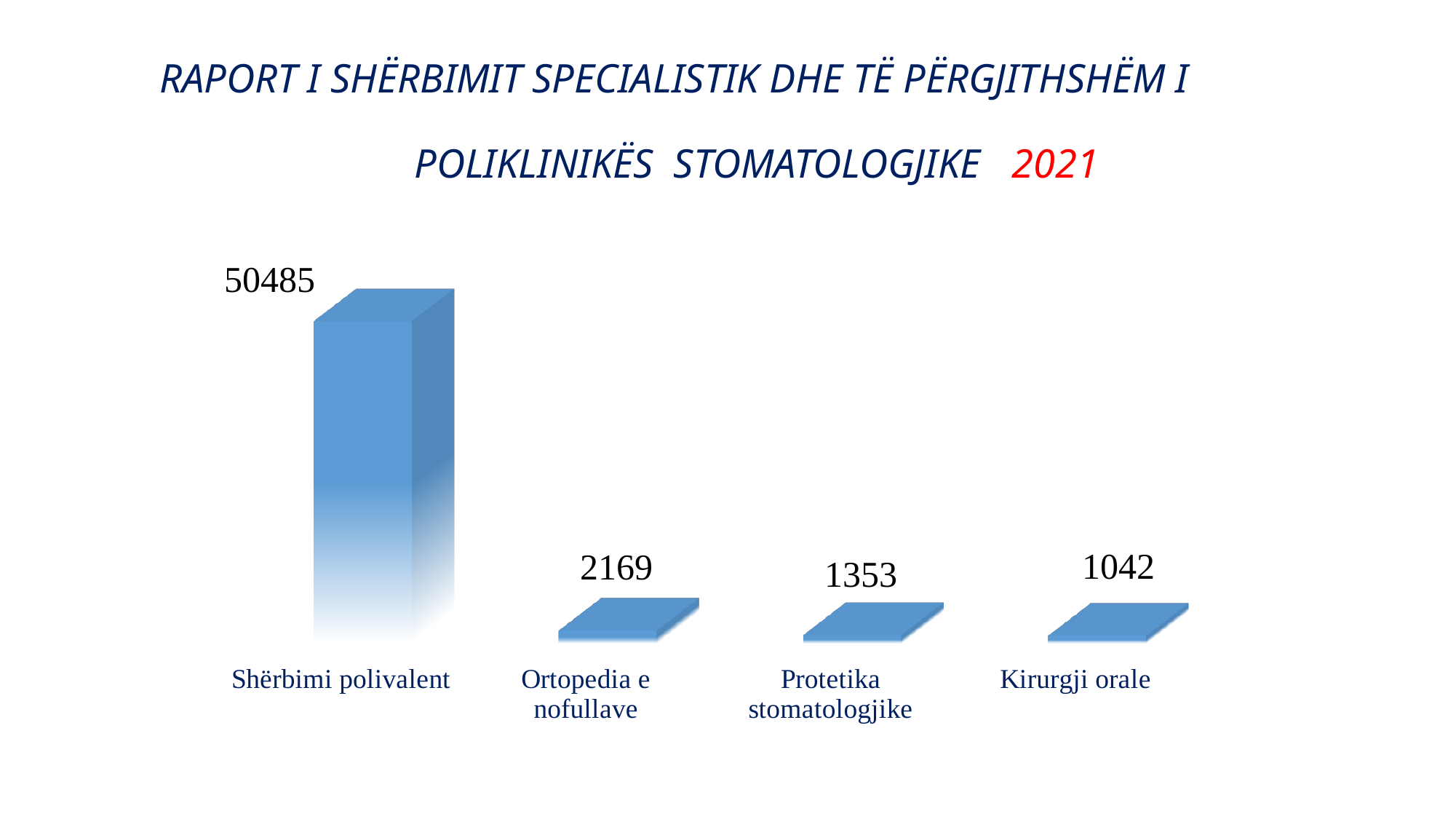
Which year is shown in red in the slide title? 2021 What is the value for Protetika stomatologjike? 1353 What is the value for Ortopedia e nofullave? 2169 What is the value for Kirurgji orale? 1042 Which category has the lowest value? Kirurgji orale What is the difference between the values for Ortopedia e nofullave and Protetika stomatologjike? 816 How many categories are shown in the chart? 4 What is the value for Shërbimi polivalent? 50485 What is the difference between the values for Protetika stomatologjike and Kirurgji orale? 311 What kind of chart is shown on the slide? Bar chart Which is larger, the value for Ortopedia e nofullave or the value for Kirurgji orale? Ortopedia e nofullave Which category has the highest value? Shërbimi polivalent